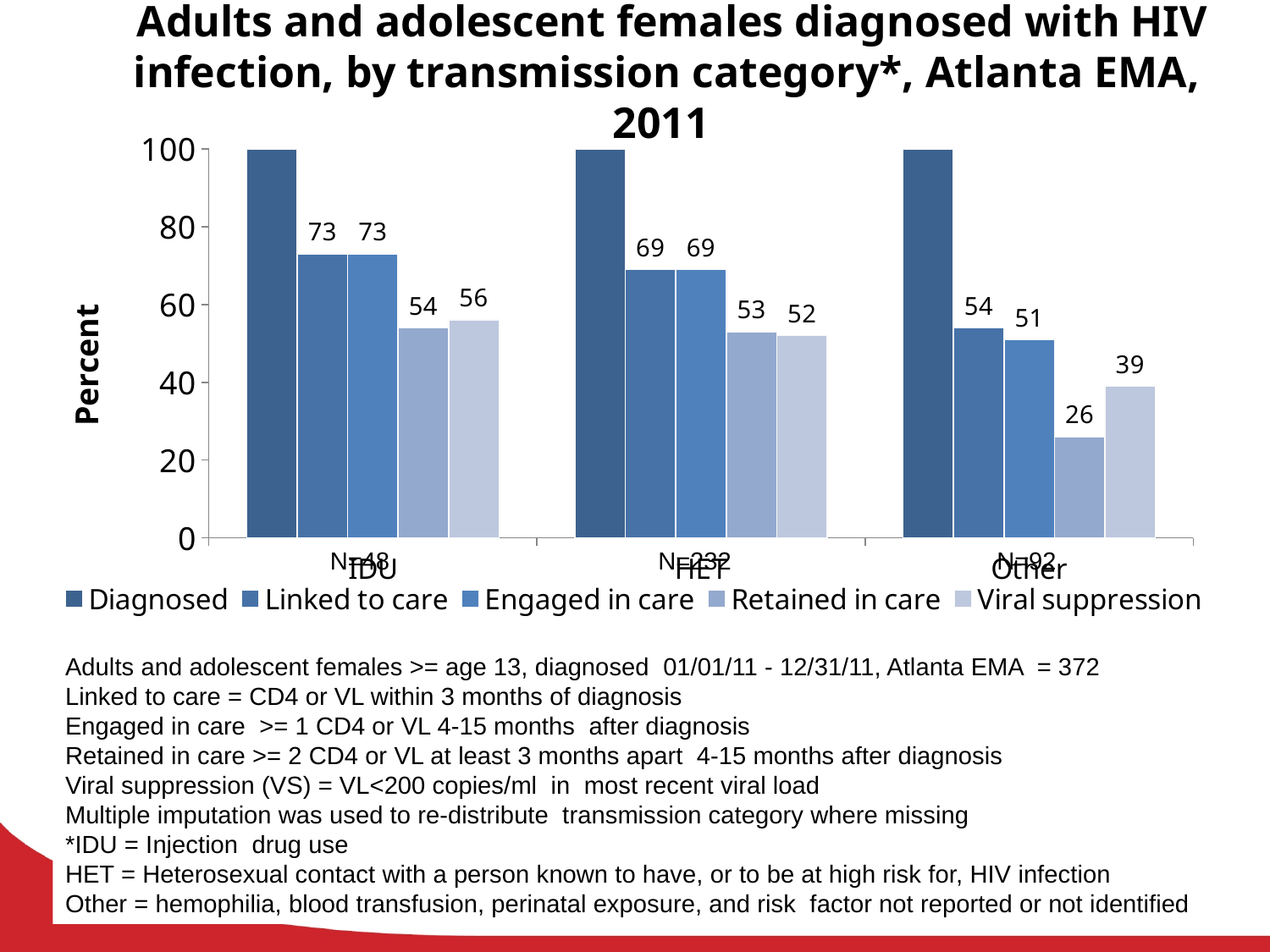
Which transmission category has the highest Viral suppression value? IDU What is the value for Linked to care in the IDU category? 73 What is the label of the y axis? Percent How many series does the legend list? 5 What is the value for Viral suppression in the Other category? 39 Is the value for Diagnosed in the HET category greater or less than 80? greater Is the Viral suppression value for HET larger or smaller than the Viral suppression value for Other? larger What is the difference between the Engaged in care values for IDU and Other? 22 Which transmission category has the lowest Retained in care value? Other What is the value for Retained in care in the HET category? 53 How many transmission categories are shown on the x axis? 3 What kind of chart is shown on the slide? bar chart